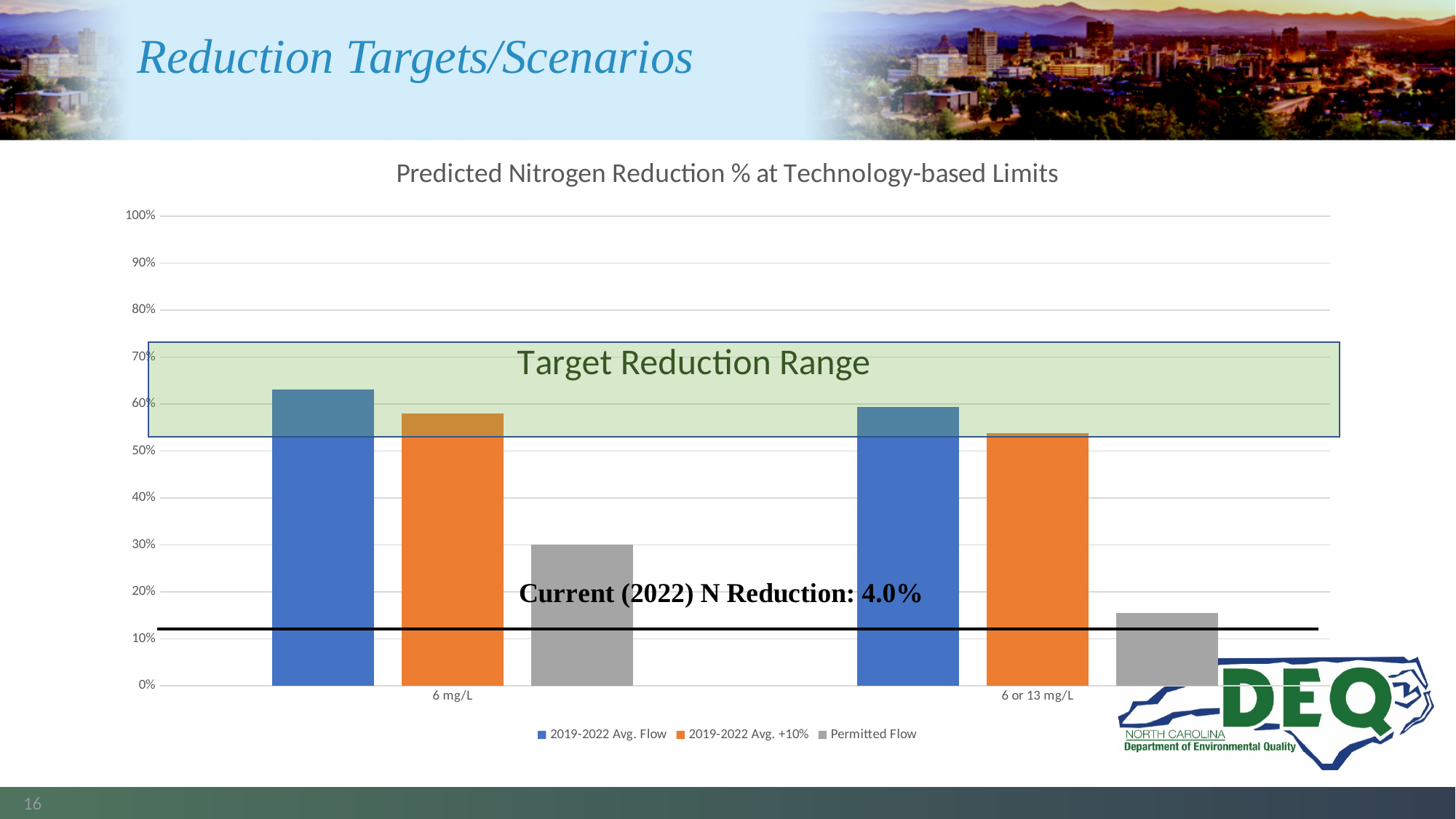
Is the value for 2019-2022 Avg. +10% at 6 or 13 mg/L greater or less than 50%? greater What is the title of the chart? Predicted Nitrogen Reduction % at Technology-based Limits For the Permitted Flow series, which category has the larger value: 6 mg/L or 6 or 13 mg/L? 6 mg/L Is the value for Permitted Flow at 6 or 13 mg/L greater or less than 20%? less How many categories are shown on the x axis of the chart? 2 Which series has the lowest bar in the 6 or 13 mg/L category? Permitted Flow Is the value for 2019-2022 Avg. +10% at 6 mg/L greater or less than 60%? less Which series is shown in gray in the chart? Permitted Flow What type of chart is shown on the slide? Bar chart How many series does the chart legend list? 3 Which series has the tallest bar in the 6 mg/L category? 2019-2022 Avg. Flow